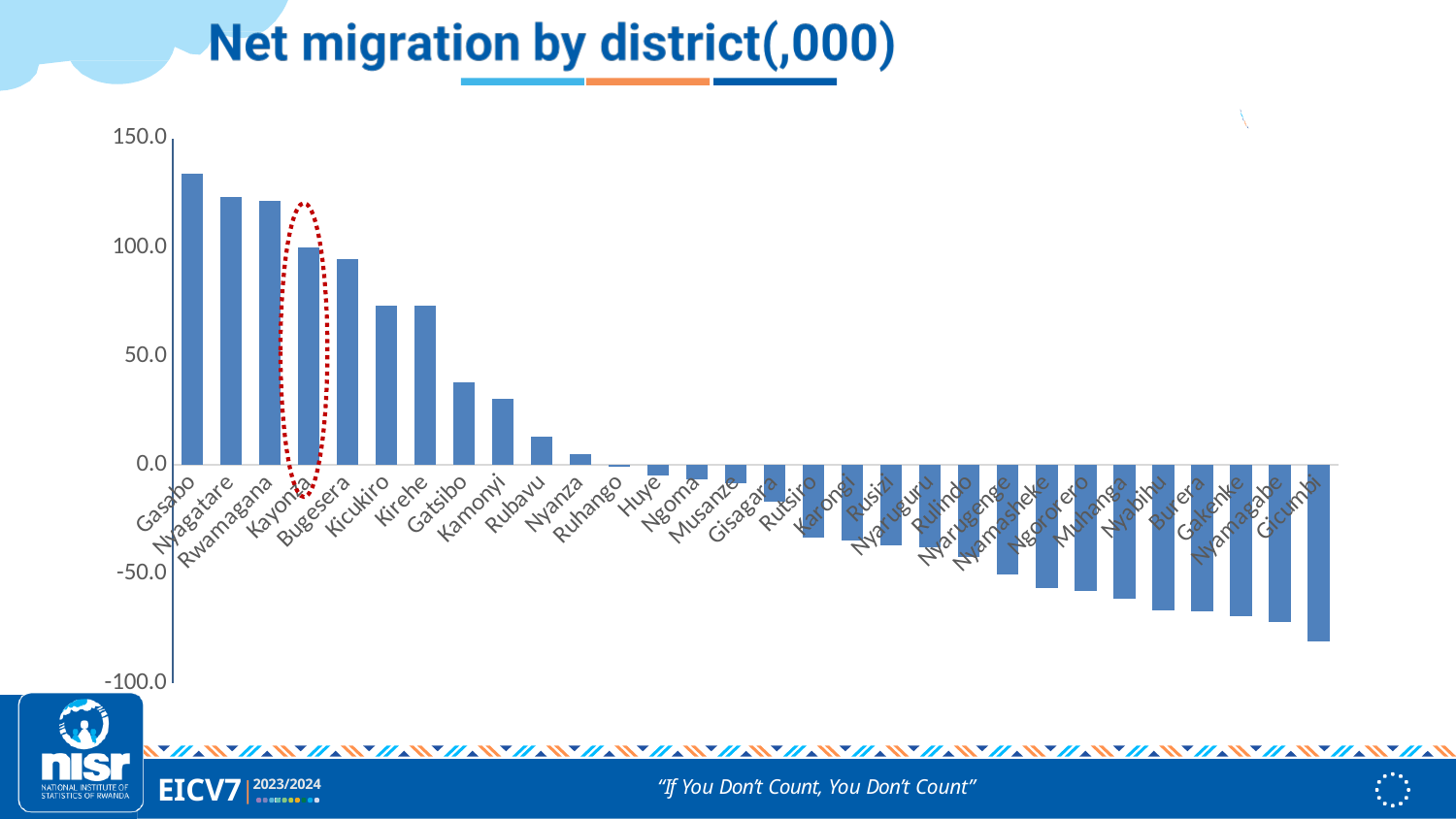
Is the value for Gasabo greater or less than 100.0? greater Which district has a larger net migration, Gasabo or Nyagatare? Gasabo Is the value for Bugesera greater or less than 100.0? less What kind of chart is shown on the slide? bar chart Is the value for Gatsibo greater or less than 50.0? less What is the title of the chart? Net migration by district(,000) Which district has the highest net migration? Gasabo Which district has the lowest net migration? Gicumbi How many districts are plotted in the chart? 30 Do the values rise or fall moving from left to right along the x axis? fall